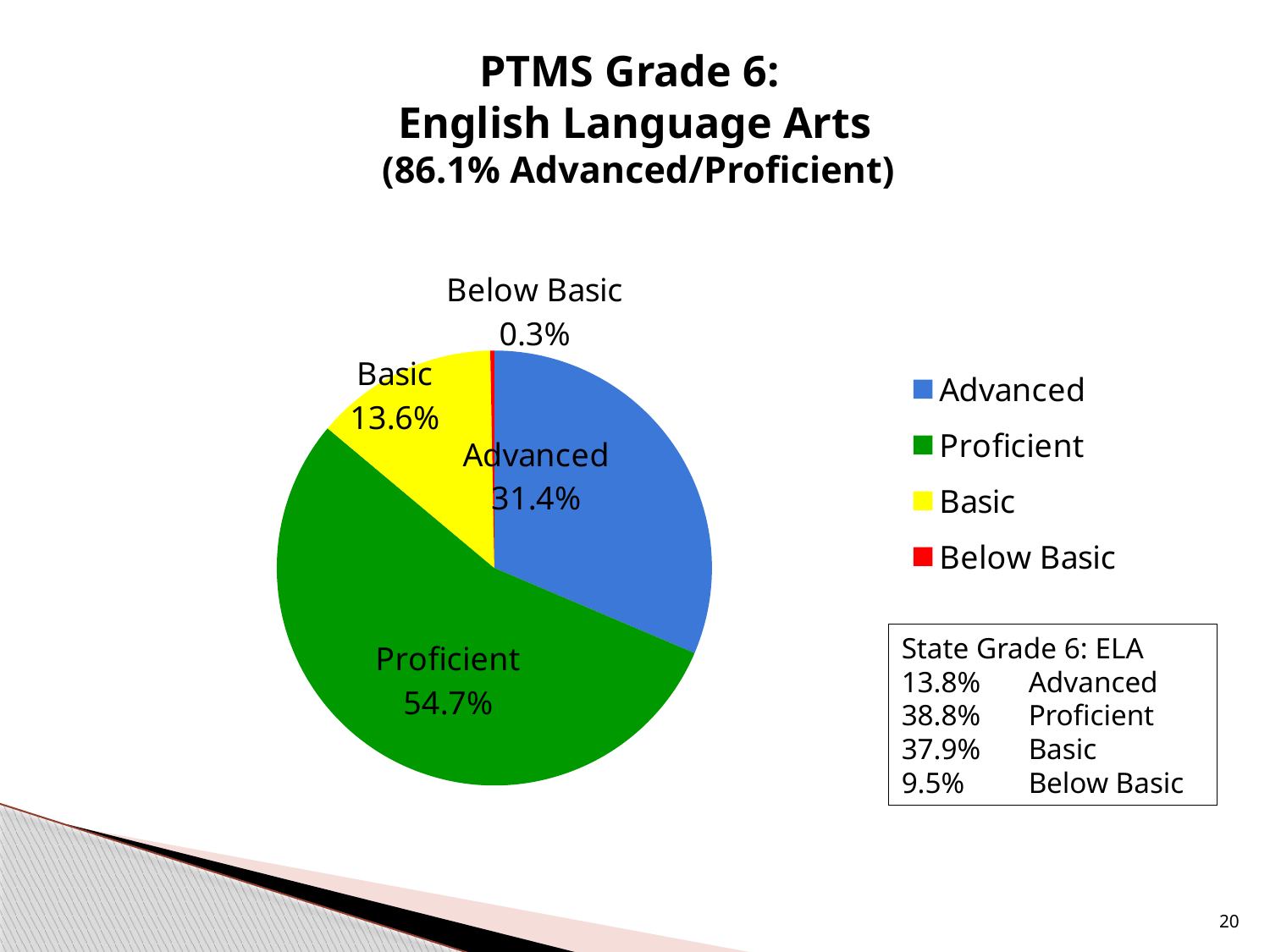
Which performance level has the largest share of the pie? Proficient What percentage of students scored Below Basic? 0.3% Which is larger, the Advanced slice or the Basic slice? Advanced How many entries does the legend list? 4 How many percentage points higher is Proficient than Advanced? 23.3 What percentage of students scored Basic? 13.6% Which performance level has the smallest share of the pie? Below Basic What type of chart is shown on the slide? pie chart What colour represents the Basic category in the pie chart? yellow How many slices does the pie chart have? 4 What percentage of students scored Advanced? 31.4% What percentage of PTMS Grade 6 students scored Proficient in English Language Arts? 54.7%